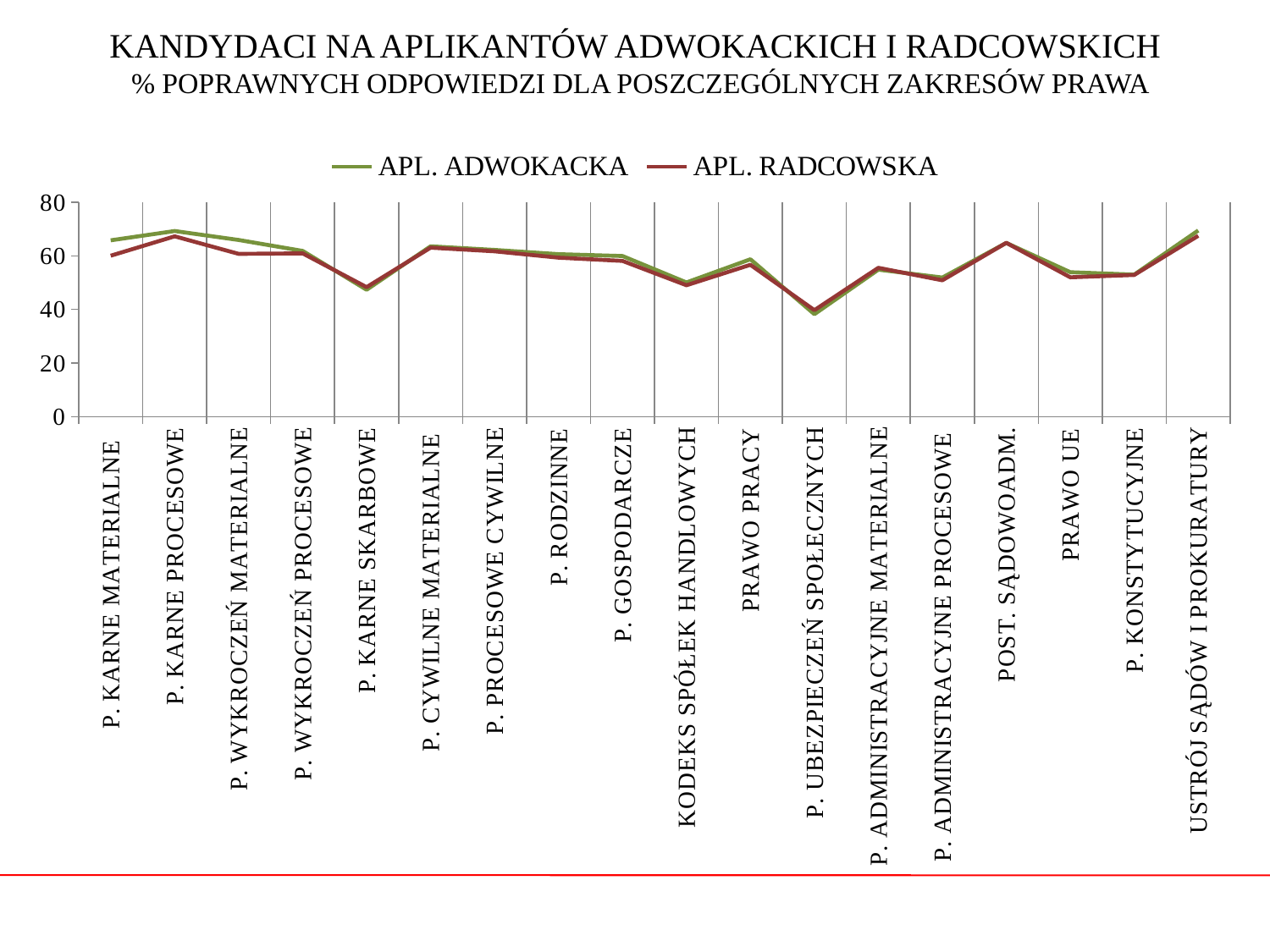
Which category has the lowest value for APL. RADCOWSKA? P. UBEZPIECZEŃ SPOŁECZNYCH Which category has the lowest value for APL. ADWOKACKA? P. UBEZPIECZEŃ SPOŁECZNYCH Is the APL. RADCOWSKA value for P. UBEZPIECZEŃ SPOŁECZNYCH greater or less than 60? less How many series does the legend list? 2 Is the APL. ADWOKACKA value for P. KARNE SKARBOWE greater or less than 60? less How many categories (areas of law) are plotted along the x axis? 18 Do the APL. RADCOWSKA values rise or fall from P. KARNE PROCESOWE to P. KARNE SKARBOWE? fall What are the two series named in the legend? APL. ADWOKACKA and APL. RADCOWSKA For APL. ADWOKACKA, which is larger: the value for P. KARNE SKARBOWE or for P. CYWILNE MATERIALNE? P. CYWILNE MATERIALNE For P. KARNE MATERIALNE, which series has the larger value: APL. ADWOKACKA or APL. RADCOWSKA? APL. ADWOKACKA Is the APL. RADCOWSKA value for POST. SĄDOWOADM. greater or less than 60? greater What kind of chart is shown on the slide? line chart